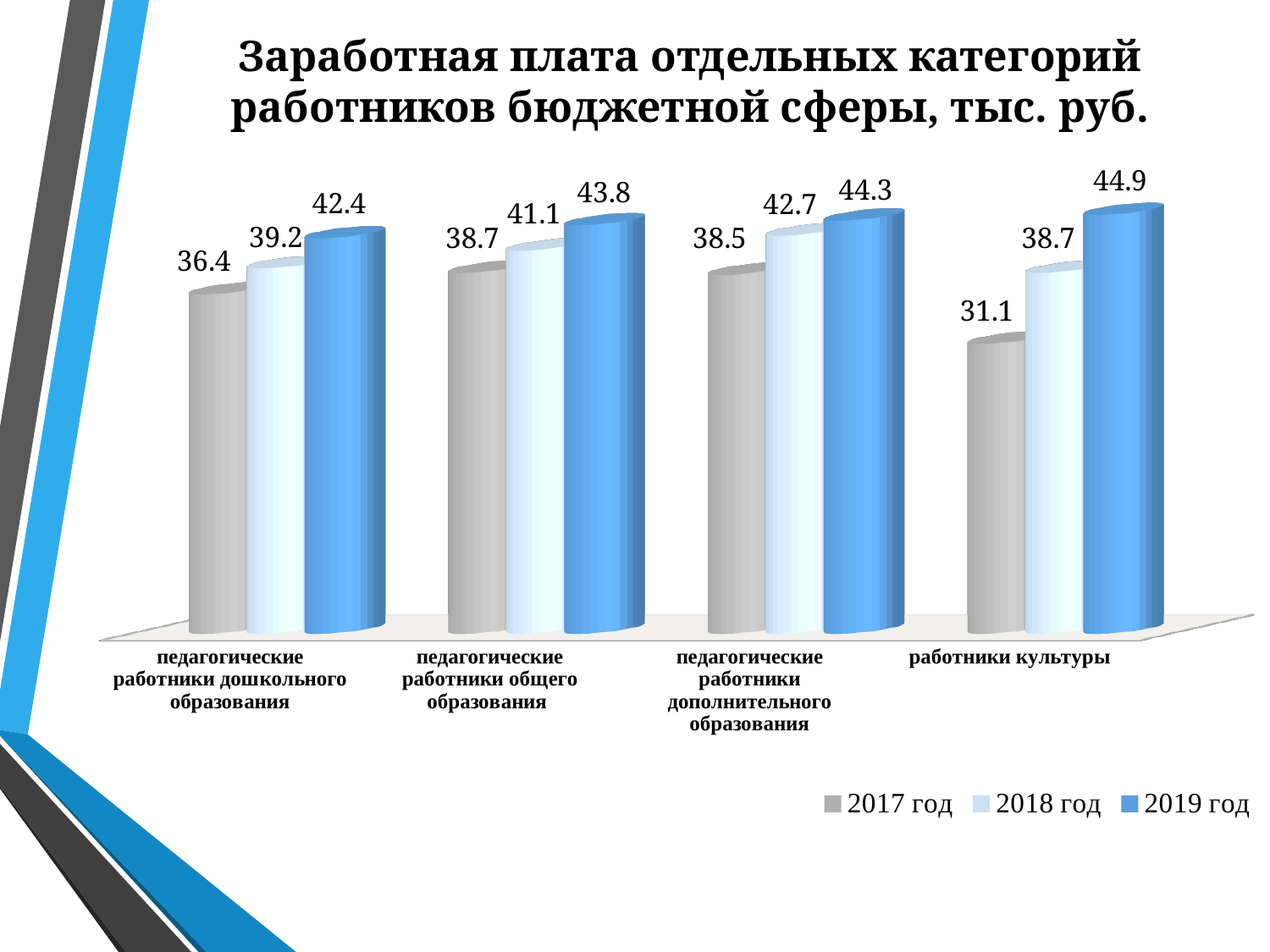
How many categories of workers are shown on the chart? 4 What is the difference between the 2019 год and 2017 год salaries for работники культуры? 13.8 How many series does the legend list? 3 Which category had the lowest salary in 2017 год? работники культуры What kind of chart is shown on the slide? bar chart What was the salary of педагогические работники дошкольного образования in 2017 год? 36.4 Which is larger: the 2018 год salary for педагогические работники дошкольного образования or the 2018 год salary for работники культуры? педагогические работники дошкольного образования What was the salary of работники культуры in 2019 год? 44.9 Which category had the highest salary in 2019 год? работники культуры What is the difference between the 2018 год and 2017 год salaries for педагогические работники дополнительного образования? 4.2 What was the salary of педагогические работники общего образования in 2018 год? 41.1 Which series is shown in dark blue in the legend? 2019 год